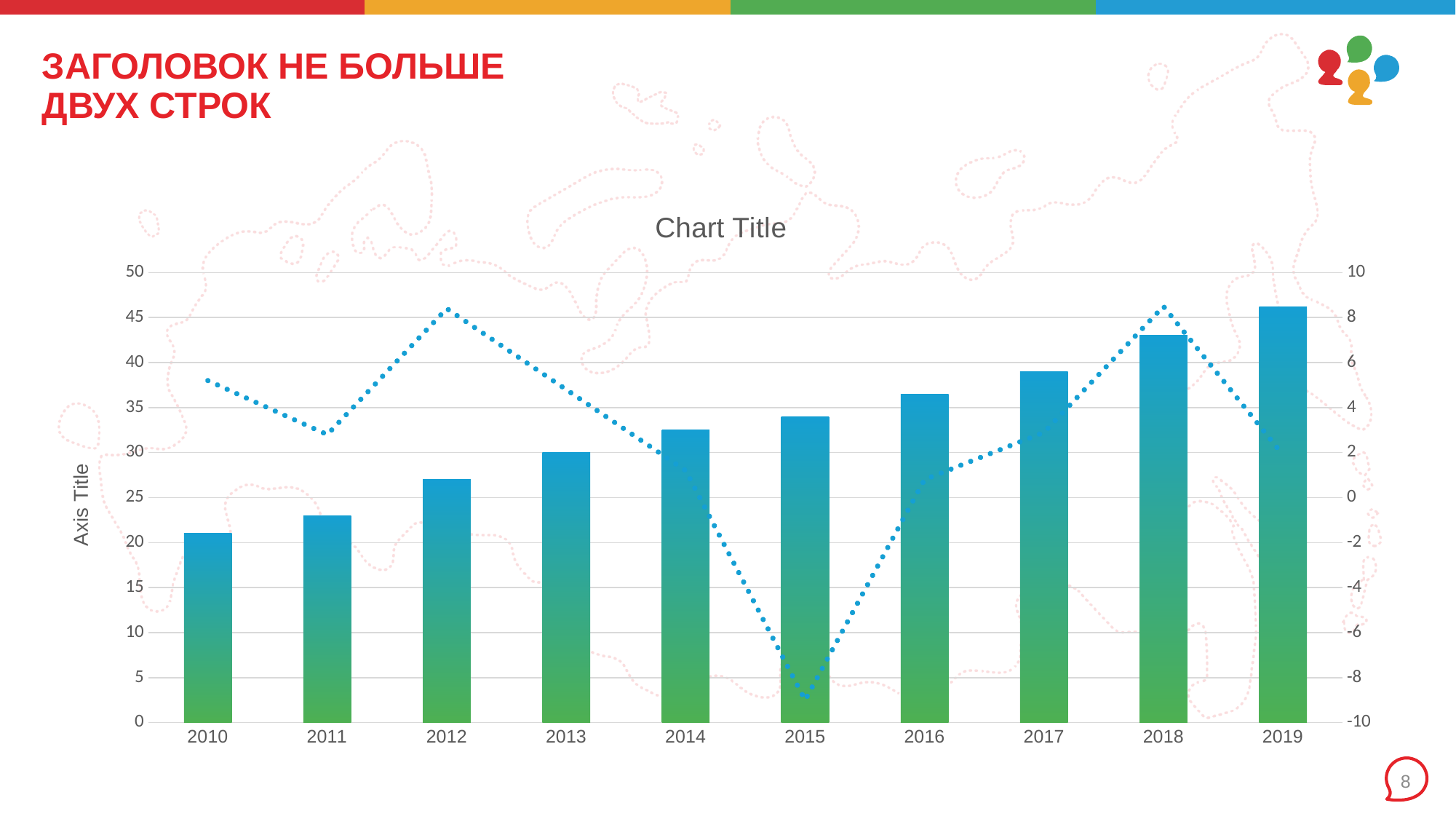
Which year has the tallest bar? 2019 Do the bar values rise or fall from 2010 to 2019? Rise What kind of chart is shown on the slide? A bar chart combined with a dotted line What is the title of the chart? Chart Title Which year has the lowest point on the dotted line? 2015 Which bar is taller, 2014 or 2018? 2018 Which year has the shortest bar? 2010 How many years are shown on the x axis of the chart? 10 Is the dotted line value for 2015 greater or less than -5 on the right axis? less